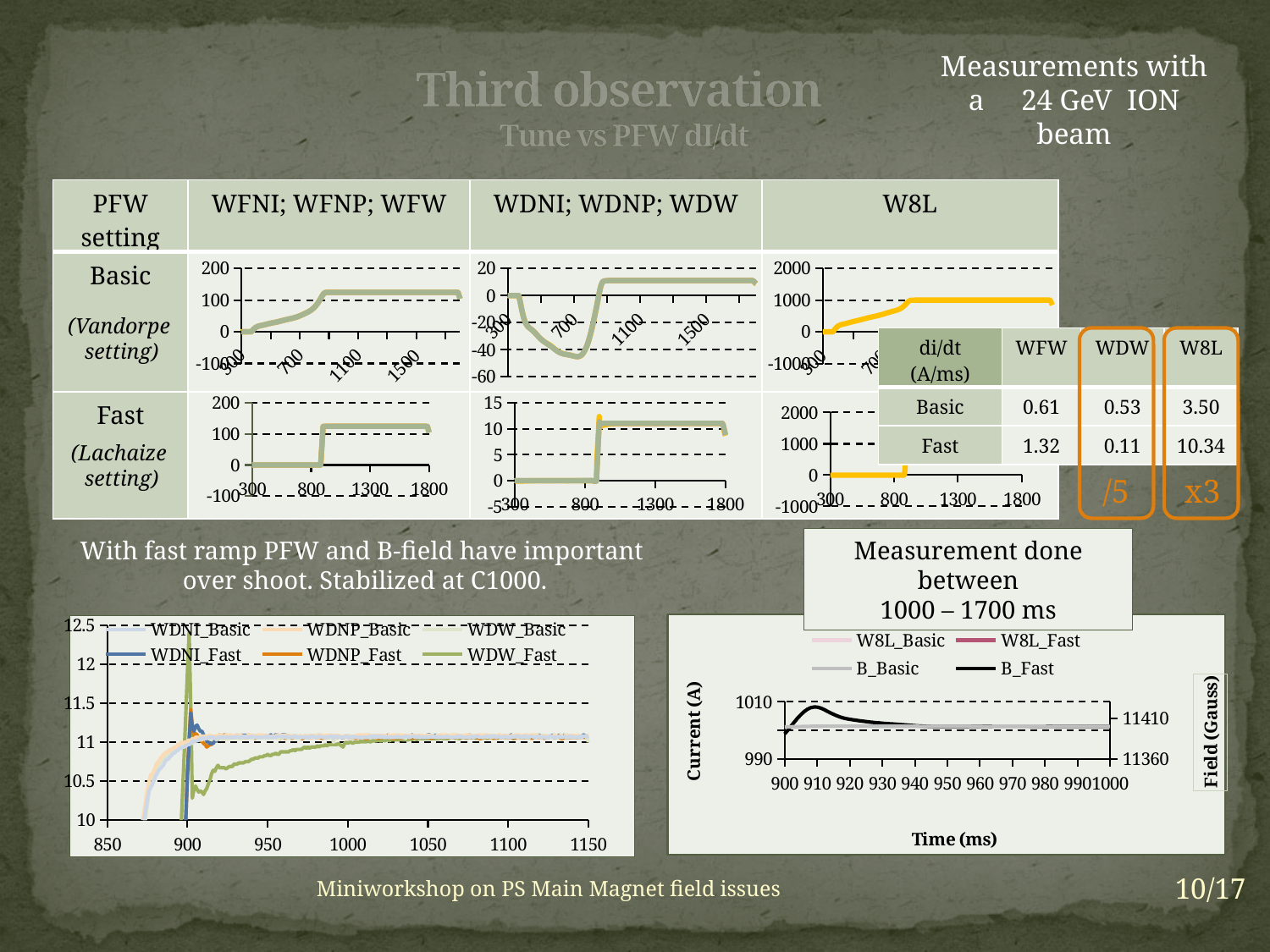
In the Fast row chart for WFNI; WFNP; WFW, is the plateau value after 1000 greater or less than 100? greater In the Basic row chart for WFNI; WFNP; WFW, do the values rise or fall along the x axis? rise What is the x-axis title of the bottom-right chart? Time (ms) How many small charts are in the PFW setting grid at the top of the slide? 6 In the bottom-left chart, is the value of WDW_Fast at x = 950 greater or less than 11? less In the Basic row chart for WDNI; WDNP; WDW, is the plateau value after 1100 greater or less than 0? greater How many series does the legend of the bottom-left chart list? 6 What is the title of the right-hand y axis of the bottom-right chart? Field (Gauss) How many series does the legend of the bottom-right chart (Current vs Time) list? 4 What kind of chart is the bottom-left chart with the WDNI/WDNP/WDW legend? line chart